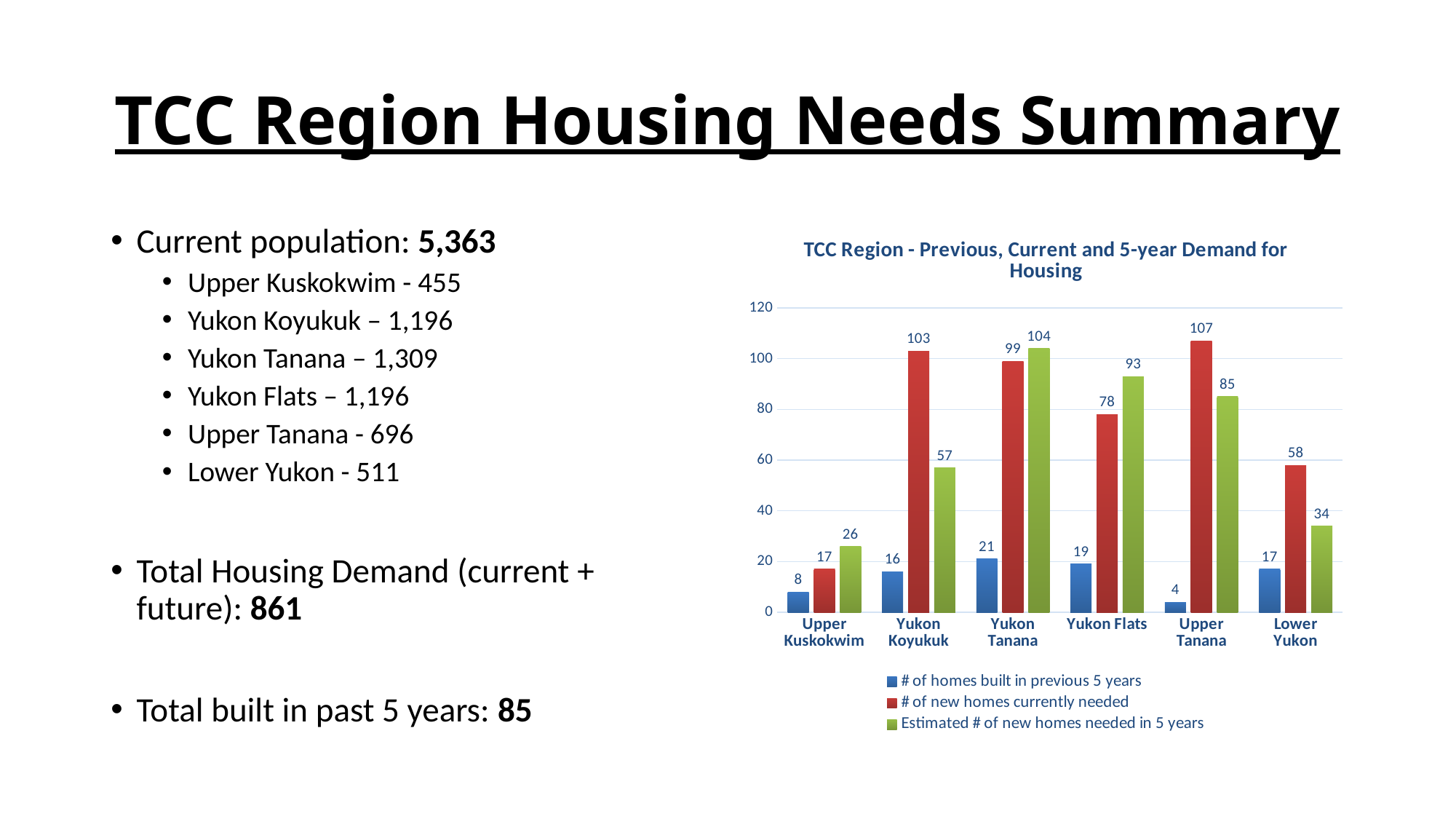
How many regions are shown on the x axis of the chart? 6 Is the estimated number of new homes needed in 5 years for Upper Tanana greater or less than 80? greater What is the number of new homes currently needed in Yukon Koyukuk? 103 What is the title of the chart? TCC Region - Previous, Current and 5-year Demand for Housing What kind of chart is shown on the slide? Bar chart What is the difference between the number of new homes currently needed and the number of homes built in the previous 5 years in Yukon Tanana? 78 Which region has the highest number of new homes currently needed? Upper Tanana Which is larger for Lower Yukon: the number of new homes currently needed or the estimated number needed in 5 years? # of new homes currently needed How many series does the chart legend list? 3 Which region has the lowest estimated number of new homes needed in 5 years? Upper Kuskokwim What is the estimated number of new homes needed in 5 years for Yukon Flats? 93 How many homes were built in the previous 5 years in Upper Tanana? 4